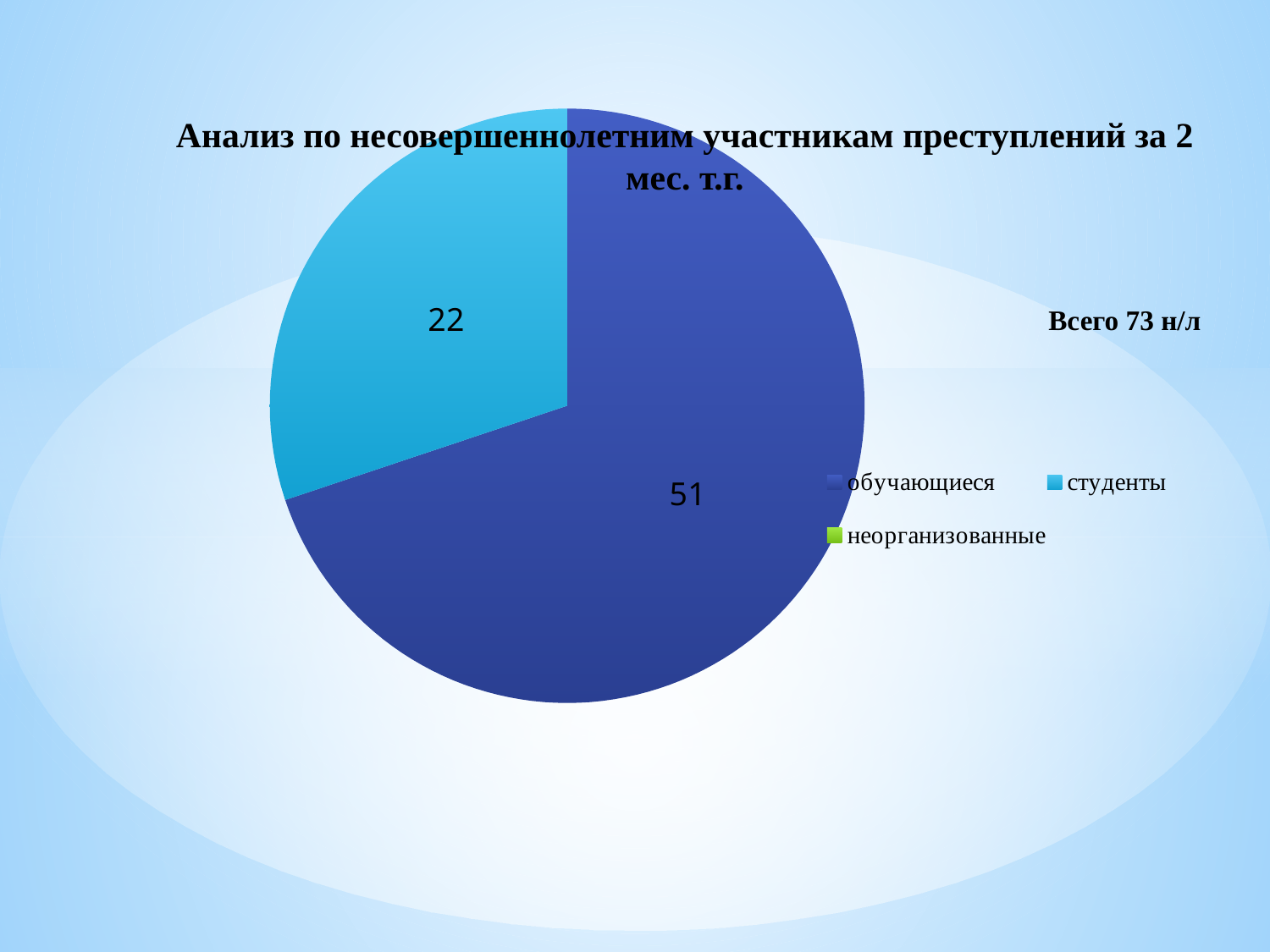
How many slices with data labels are visible in the pie chart? 2 Which legend entry of the pie chart is marked with a green colour? неорганизованные What is the difference between the обучающиеся value and the студенты value in the pie chart? 29 Which category has the largest slice in the pie chart? обучающиеся What kind of chart is shown on the slide? pie chart Which is larger in the pie chart: the value for студенты or the value for обучающиеся? обучающиеся Which of the two labelled slices, обучающиеся or студенты, is smaller? студенты What total number of minors is stated on the slide next to the pie chart? 73 How many entries does the legend of the pie chart list? 3 What is the title of the chart on the slide? Анализ по несовершеннолетним участникам преступлений за 2 мес. т.г. What is the value shown for the студенты slice of the pie chart? 22 What is the value shown for the обучающиеся slice of the pie chart? 51